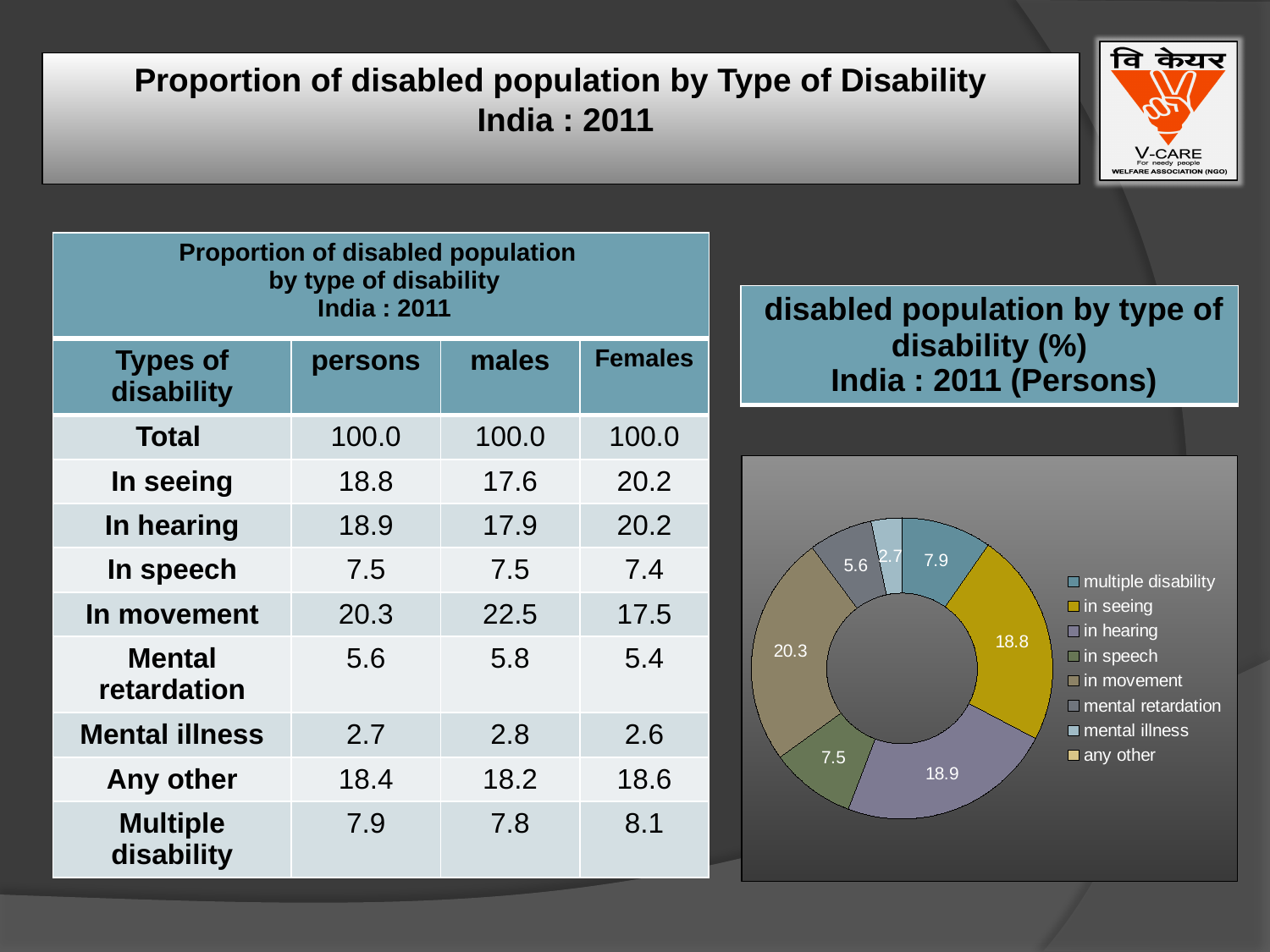
Which is larger in the chart, the value for 'in speech' or the value for 'multiple disability'? multiple disability What is the title of the chart on the slide? disabled population by type of disability (%) India : 2011 (Persons) How many entries does the chart's legend list? 8 What value does the chart show for 'in hearing'? 18.9 What is the difference between the values for 'in hearing' and 'in seeing' in the chart? 0.1 What is the value labelled for 'multiple disability' in the chart? 7.9 What kind of chart is shown on the slide? doughnut chart Which labelled category in the chart has the smallest value? mental illness What value is shown for 'in speech' in the chart? 7.5 What is the difference between the values for 'in movement' and 'mental retardation' in the chart? 14.7 What value is shown for 'mental illness' in the chart? 2.7 What is the value shown for 'in movement' in the doughnut chart? 20.3